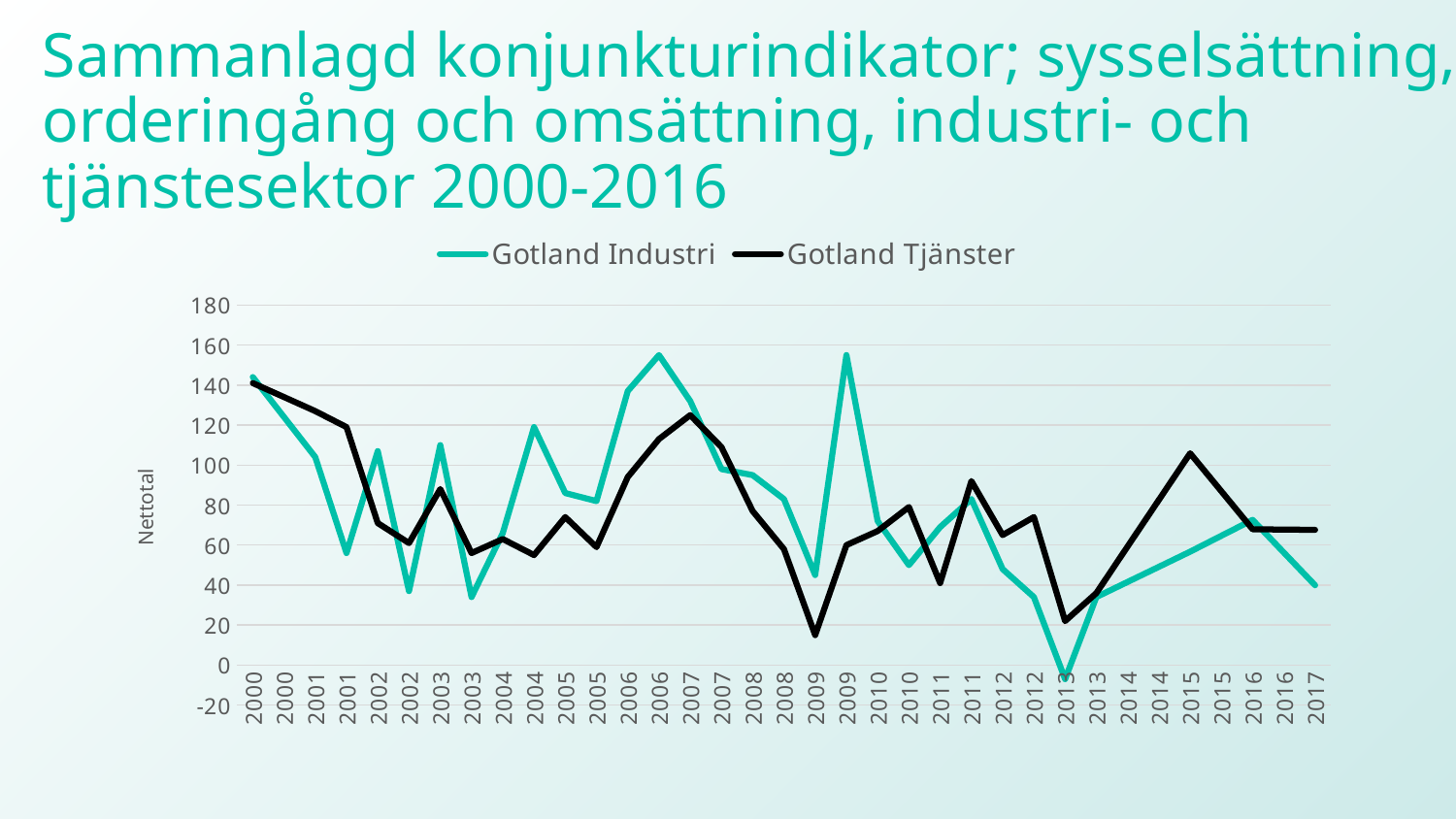
What kind of chart is shown on the slide? line chart Is the value for Gotland Industri at the second 2009 point greater or less than 140? greater Which two series are listed in the legend? Gotland Industri and Gotland Tjänster At which x-axis point does Gotland Industri reach its lowest value? the first 2013 point Is the value for Gotland Industri at the first 2013 point greater or less than 20? less How many series does the legend list? 2 Is the value for Gotland Tjänster at the second 2009 point greater or less than 40? greater Does the Gotland Tjänster line rise or fall from the first 2000 point to the first 2002 point? fall What is the label on the vertical axis? Nettotal At the second 2009 point, which series has the larger value, Gotland Industri or Gotland Tjänster? Gotland Industri At which x-axis point does Gotland Tjänster reach its lowest value? the first 2009 point